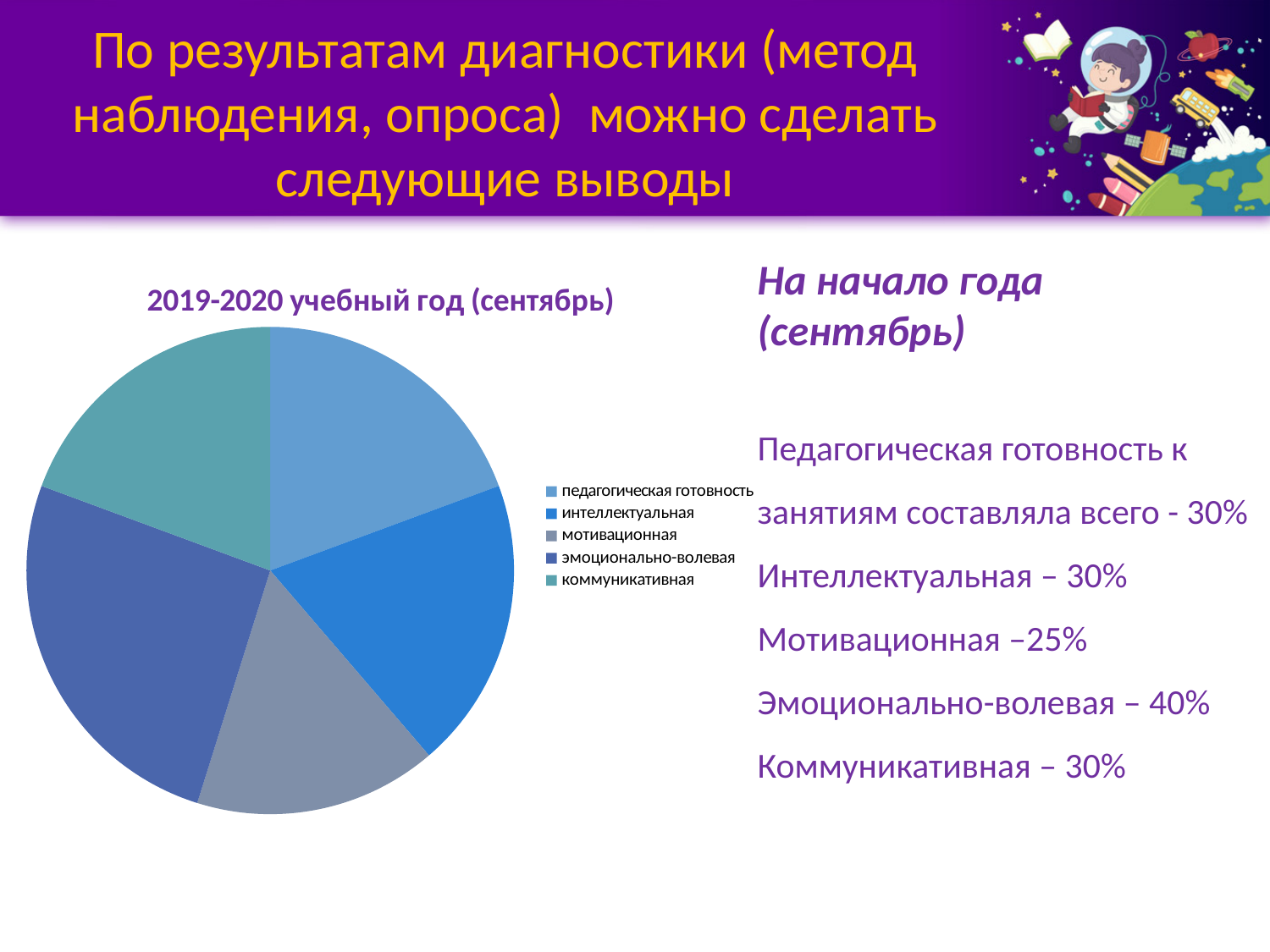
What is the title of the pie chart? 2019-2020 учебный год (сентябрь) How many slices does the pie chart have? 5 Which legend entry is listed first in the pie chart's legend? педагогическая готовность Which category has the smallest slice in the pie chart? мотивационная In the pie chart, which slice is larger: эмоционально-волевая or мотивационная? эмоционально-волевая Which category has the largest slice in the pie chart? эмоционально-волевая What kind of chart is shown on the slide? pie chart In the pie chart, which slice is larger: эмоционально-волевая or интеллектуальная? эмоционально-волевая How many entries does the legend of the pie chart list? 5